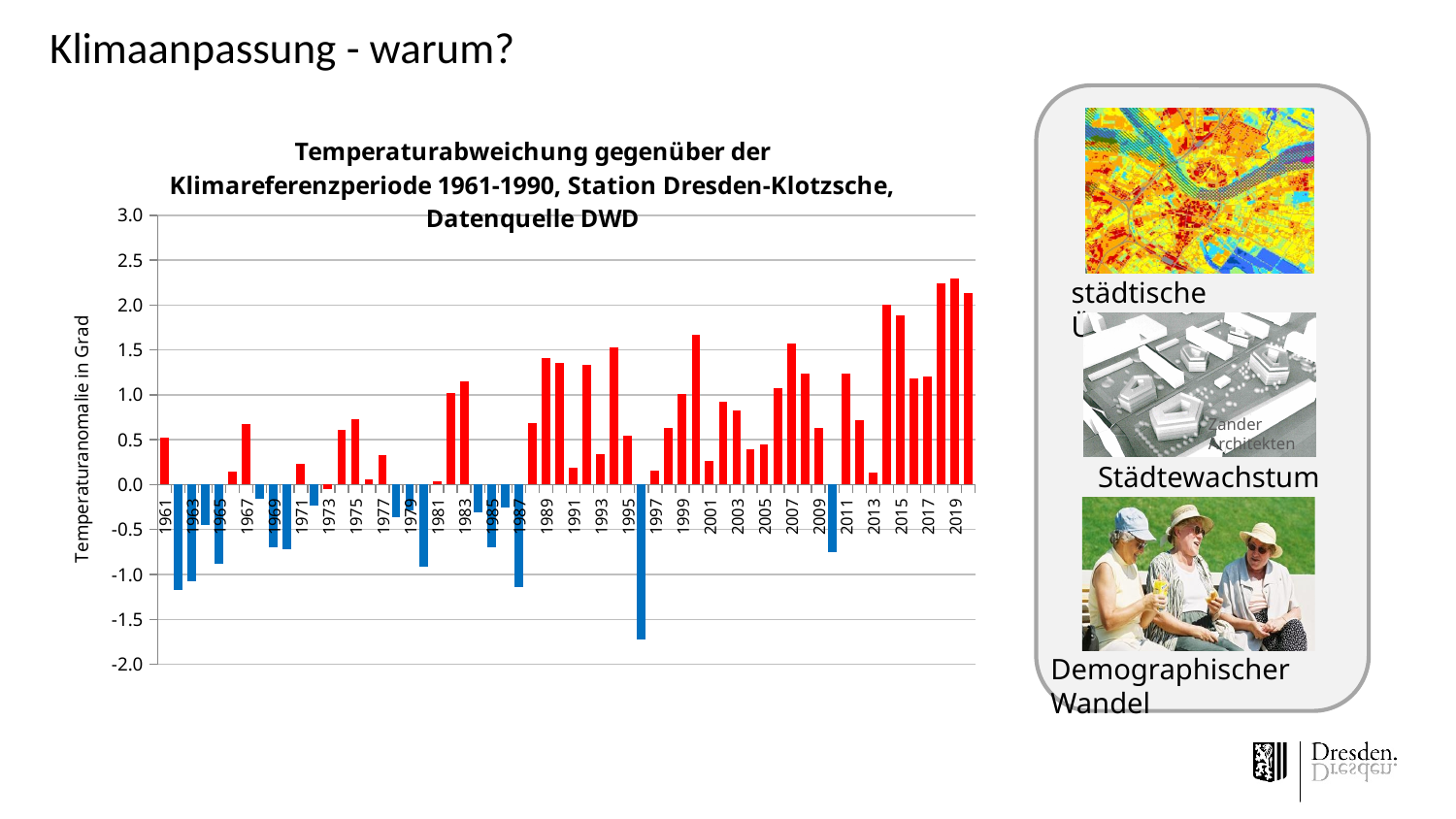
Is the value for 2015 greater or less than 1.5? greater Is the value for 2007 greater or less than 1.0? greater What is the title of the y axis of the chart? Temperaturanomalie in Grad Which station's data does the chart title say is shown? Dresden-Klotzsche Do the temperature anomaly values generally rise or fall from 1961 to 2019? rise Is the value for 2019 greater or less than 2.0? greater What kind of chart is shown on the slide? bar chart Which year has the larger value, 2019 or 1989? 2019 Which year has the larger value, 1965 or 1967? 1967